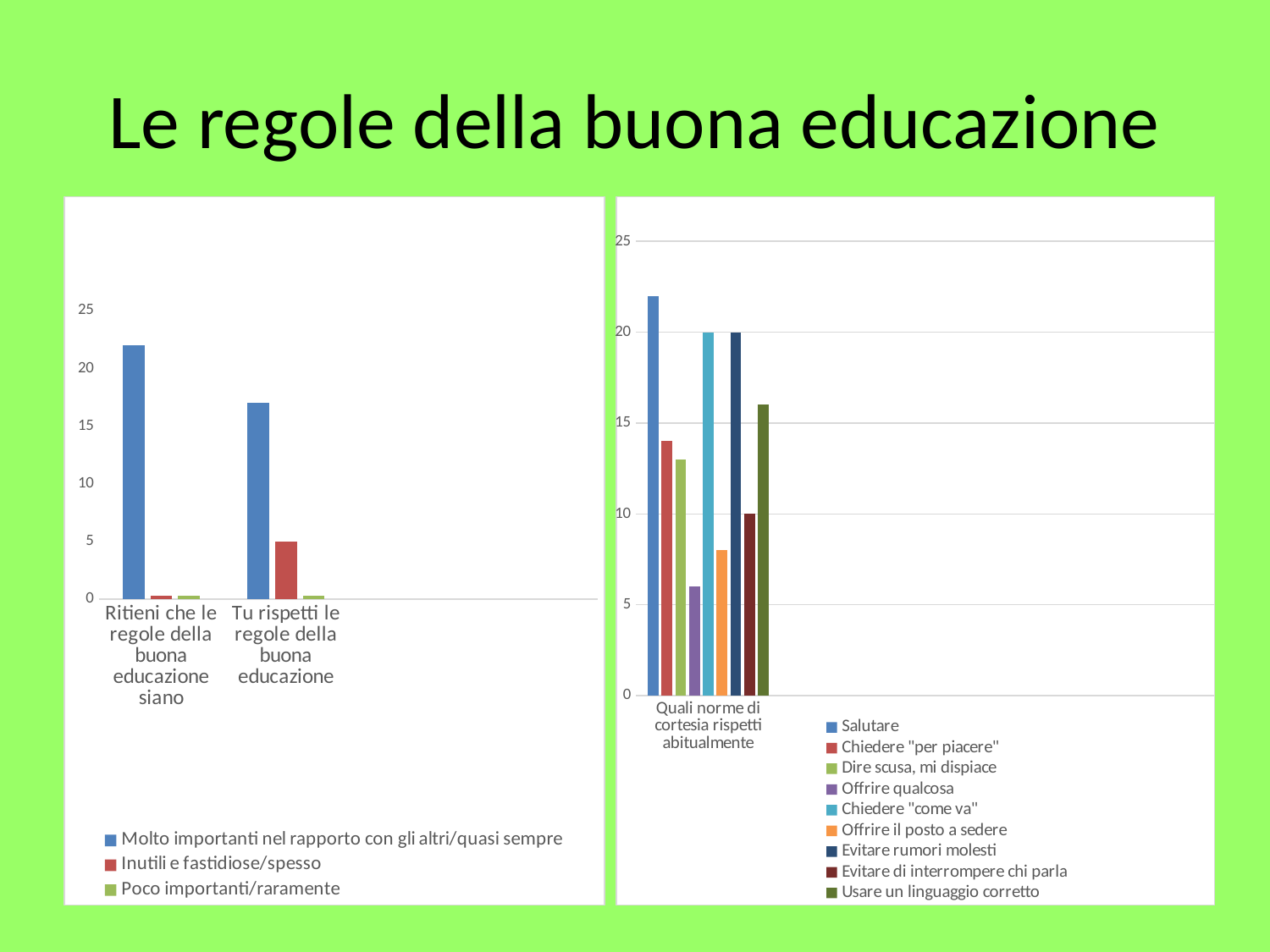
In the left chart, is the value of 'Inutili e fastidiose/spesso' for 'Tu rispetti le regole della buona educazione' greater or less than 10? less In the left chart, is the value of 'Molto importanti nel rapporto con gli altri/quasi sempre' for 'Tu rispetti le regole della buona educazione' greater or less than 15? greater In the right chart, is the value for 'Chiedere "per piacere"' greater or less than 10? greater What kind of chart is the chart on the left of the slide? bar chart How many series does the legend of the left chart list? 3 In the right chart, which series has the lowest value? Offrire qualcosa In the right chart, which series has the highest value? Salutare How many series does the legend of the right chart list? 9 In the left chart, which series has the highest value for 'Ritieni che le regole della buona educazione siano'? Molto importanti nel rapporto con gli altri/quasi sempre How many categories are shown on the x axis of the left chart? 2 In the right chart, which is larger: the value for 'Salutare' or the value for 'Usare un linguaggio corretto'? Salutare